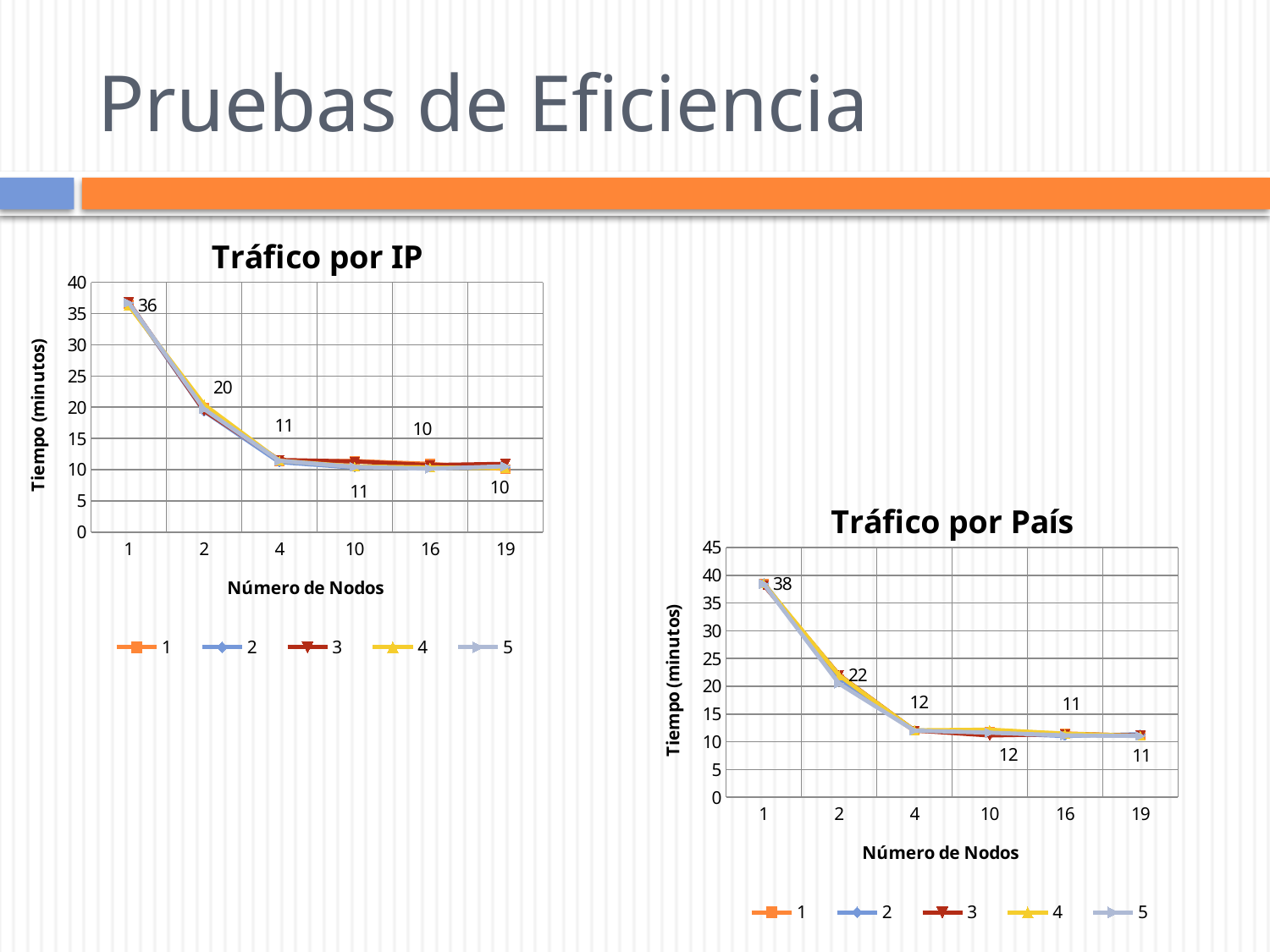
In the 'Tráfico por País' chart, what value is labelled at 2 nodes? 22 In the 'Tráfico por IP' chart, what is the difference between the labelled values at 1 node and 2 nodes? 16 In the 'Tráfico por IP' chart, what value is labelled at 1 node? 36 What is the title of the vertical axis in the 'Tráfico por País' chart? Tiempo (minutos) In the 'Tráfico por País' chart, how many values are shown on the 'Número de Nodos' axis? 6 In the 'Tráfico por IP' chart, what value is labelled at 2 nodes? 20 In the 'Tráfico por País' chart, what value is labelled at 1 node? 38 In the 'Tráfico por País' chart, what is the difference between the labelled values at 1 node and 2 nodes? 16 In the 'Tráfico por IP' chart, how many series does the legend list? 5 What kind of chart is the 'Tráfico por IP' chart? line chart In the 'Tráfico por IP' chart, is the value at 4 nodes greater or less than 20? less In the 'Tráfico por País' chart, do the values rise or fall as the number of nodes increases? fall